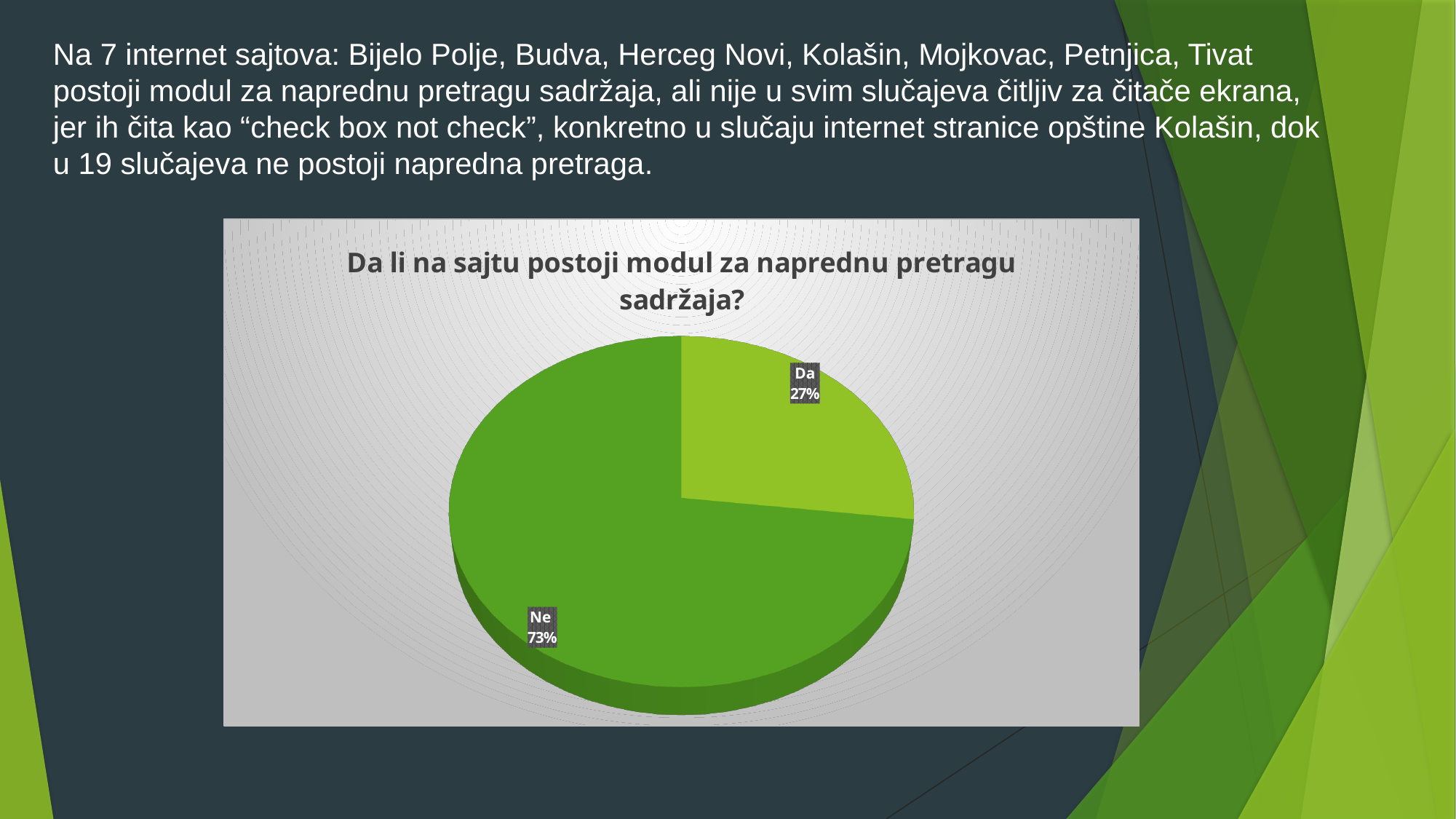
What share of the pie does the "Ne" slice represent? 73% Which slice is shown in the lighter green colour? Da What is the title of the chart? Da li na sajtu postoji modul za naprednu pretragu sadržaja? What is the combined share of the "Da" and "Ne" slices? 100% What is the difference in percentage points between the "Ne" and "Da" slices? 46 How many slices does the pie chart have? 2 Which slice of the pie is the smallest? Da Which is larger, the "Da" slice or the "Ne" slice? Ne Which slice of the pie is the largest? Ne What kind of chart is shown on the slide? pie chart What share of the pie does the "Da" slice represent? 27%